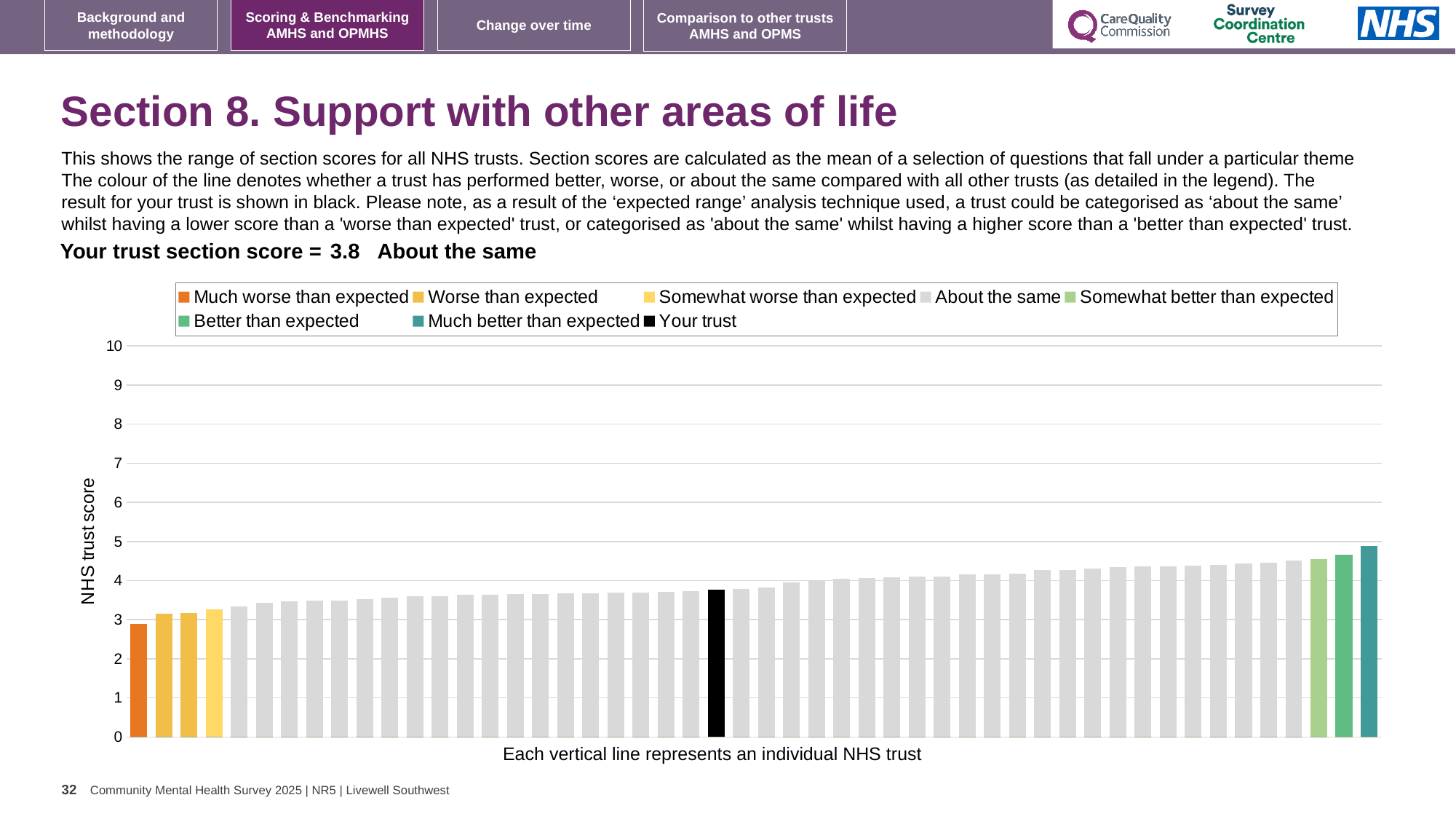
Is the value for your trust greater or less than 3? greater Which legend category does the shortest bar belong to? Much worse than expected What kind of chart is shown on the slide? bar chart What is the label on the y axis? NHS trust score How many entries does the chart legend list? 8 What is the section score for your trust? 3.8 What colour is used for the 'Your trust' bar? black Do the bar values rise or fall from left to right along the x axis? rise Which legend category does the tallest bar belong to? Much better than expected Is the value for the highest bar greater or less than 4? greater Is the value for the lowest bar greater or less than 4? less Which category is your trust placed in for this section? About the same